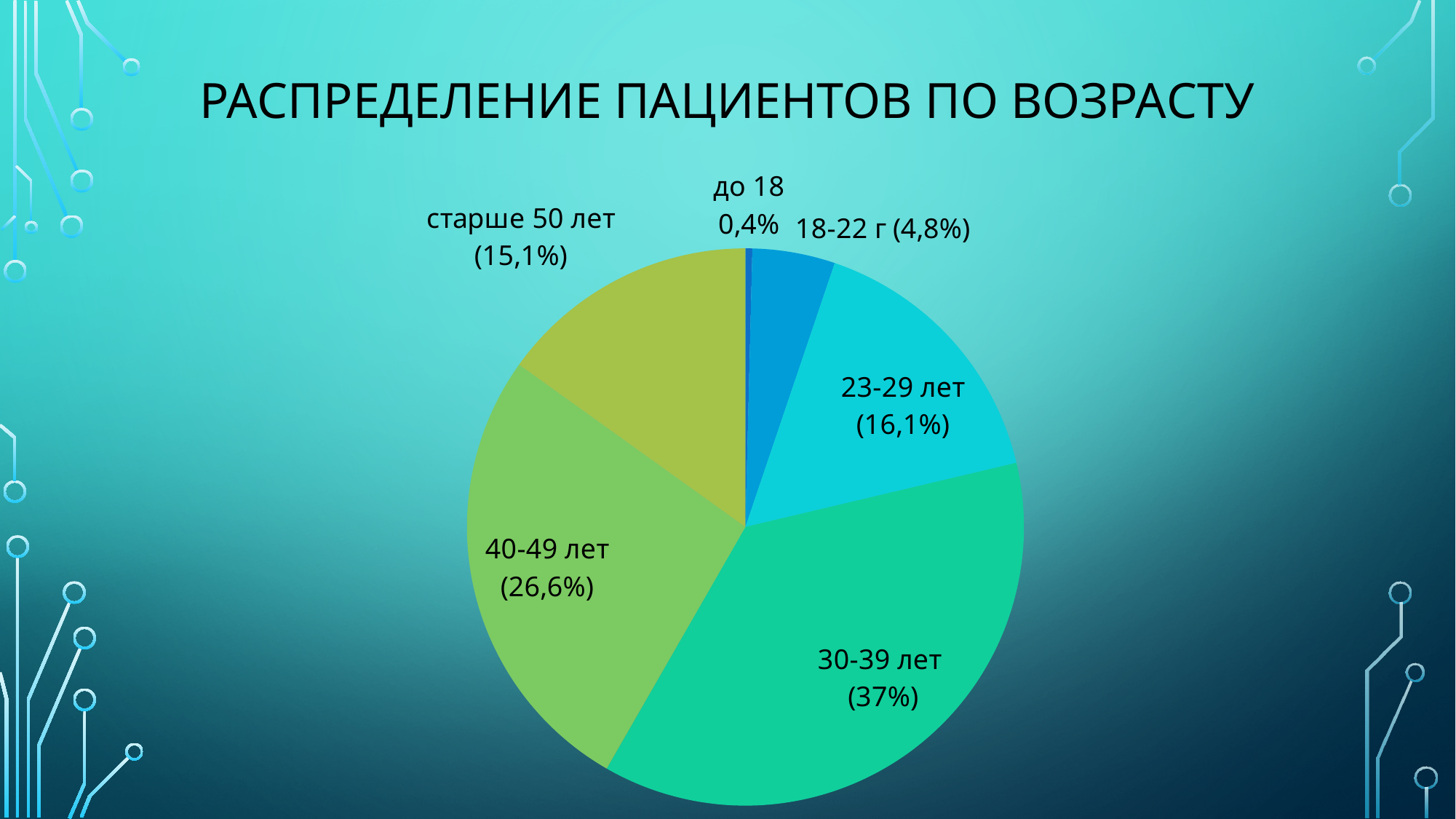
Which age group has the smallest share of patients? до 18 What share of patients are in the 40-49 лет age group? 26,6% How many age groups are shown in the pie chart? 6 What kind of chart is shown on the slide? Pie chart What share of patients are in the 30-39 лет age group? 37% What share of patients are older than 50 (старше 50 лет)? 15,1% Which age group has the largest share of patients? 30-39 лет Which group has a larger share: 23-29 лет or старше 50 лет? 23-29 лет What is the difference in percentage points between the 30-39 лет and 40-49 лет groups? 10,4